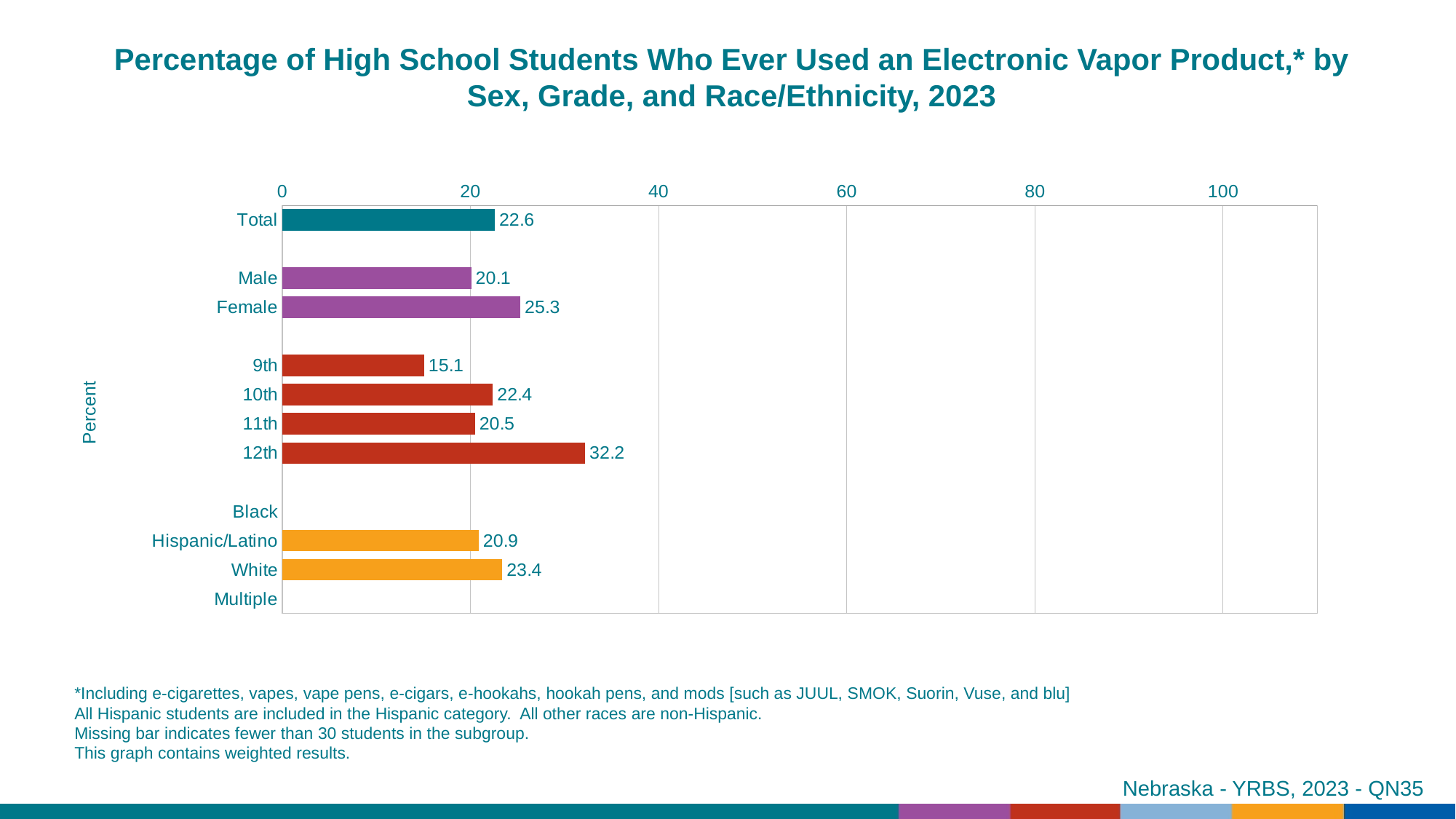
What is the difference between the 12th grade and 9th grade values? 17.1 What is the value for Hispanic/Latino? 20.9 What is the difference between the Female and Male values? 5.2 Which race/ethnicity categories have no bar shown? Black and Multiple What is the value for 12th grade? 32.2 Is the value for 12th grade greater or less than 40? less What kind of chart is this? bar chart How many categories have a bar plotted? 9 Which category has the highest value? 12th Which is larger, the value for White or the value for Hispanic/Latino? White What is the value for Total? 22.6 Which category with a bar has the lowest value? 9th